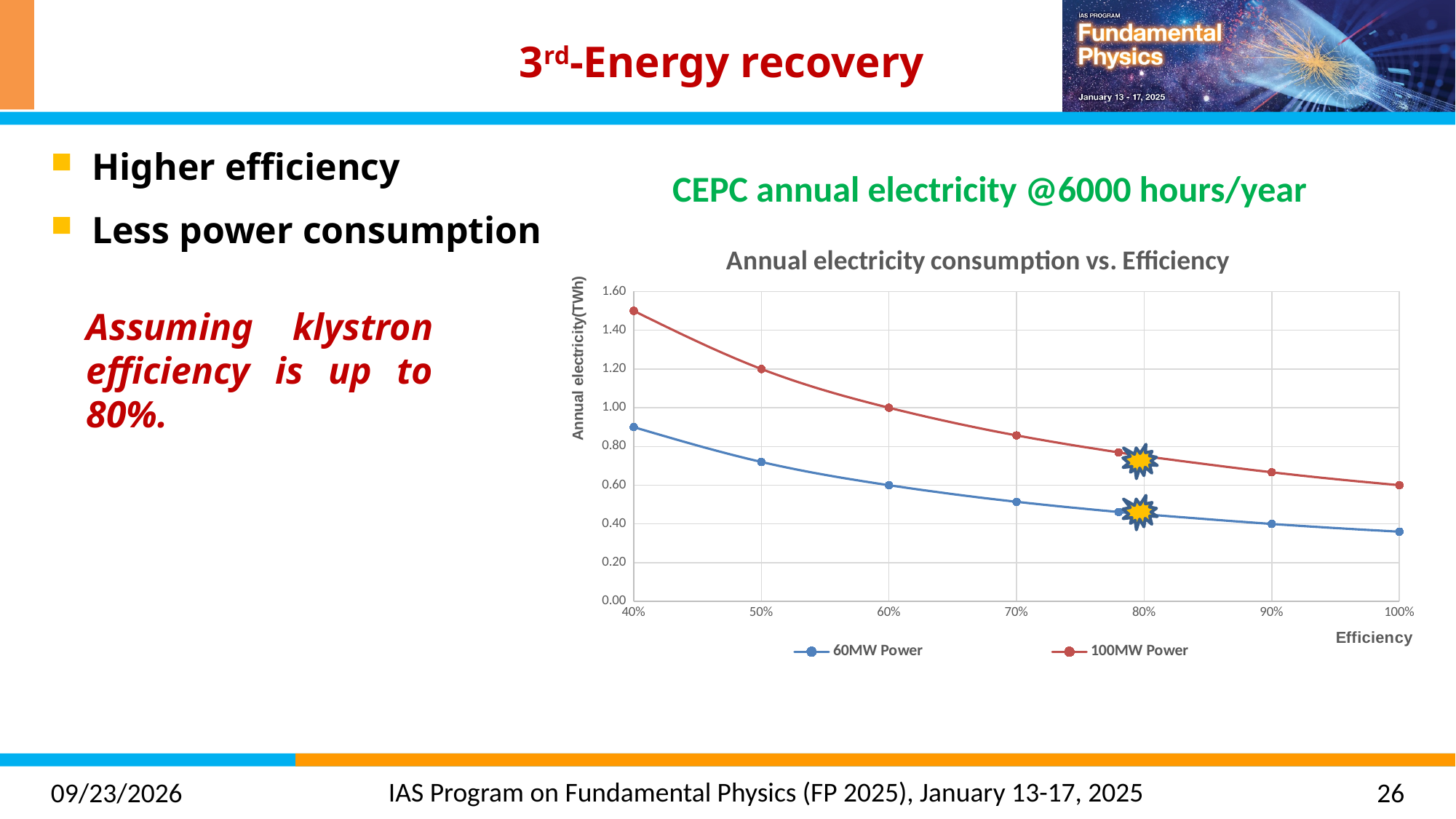
What is the title of the chart? Annual electricity consumption vs. Efficiency What is the annual electricity consumption for 100MW Power at 100% efficiency? 0.60 What kind of chart is shown on the slide? line chart Do the values of the 100MW Power series rise or fall as efficiency increases? fall Is the value for 100MW Power at 40% efficiency greater or less than 1.40? greater What is the annual electricity consumption for 60MW Power at 90% efficiency? 0.40 At 70% efficiency, which series has the higher annual electricity consumption, 60MW Power or 100MW Power? 100MW Power Is the value for 60MW Power at 80% efficiency greater or less than 0.60? less How many series does the chart legend list? 2 What is the annual electricity consumption for 60MW Power at 60% efficiency? 0.60 What is the annual electricity consumption for 100MW Power at 50% efficiency? 1.20